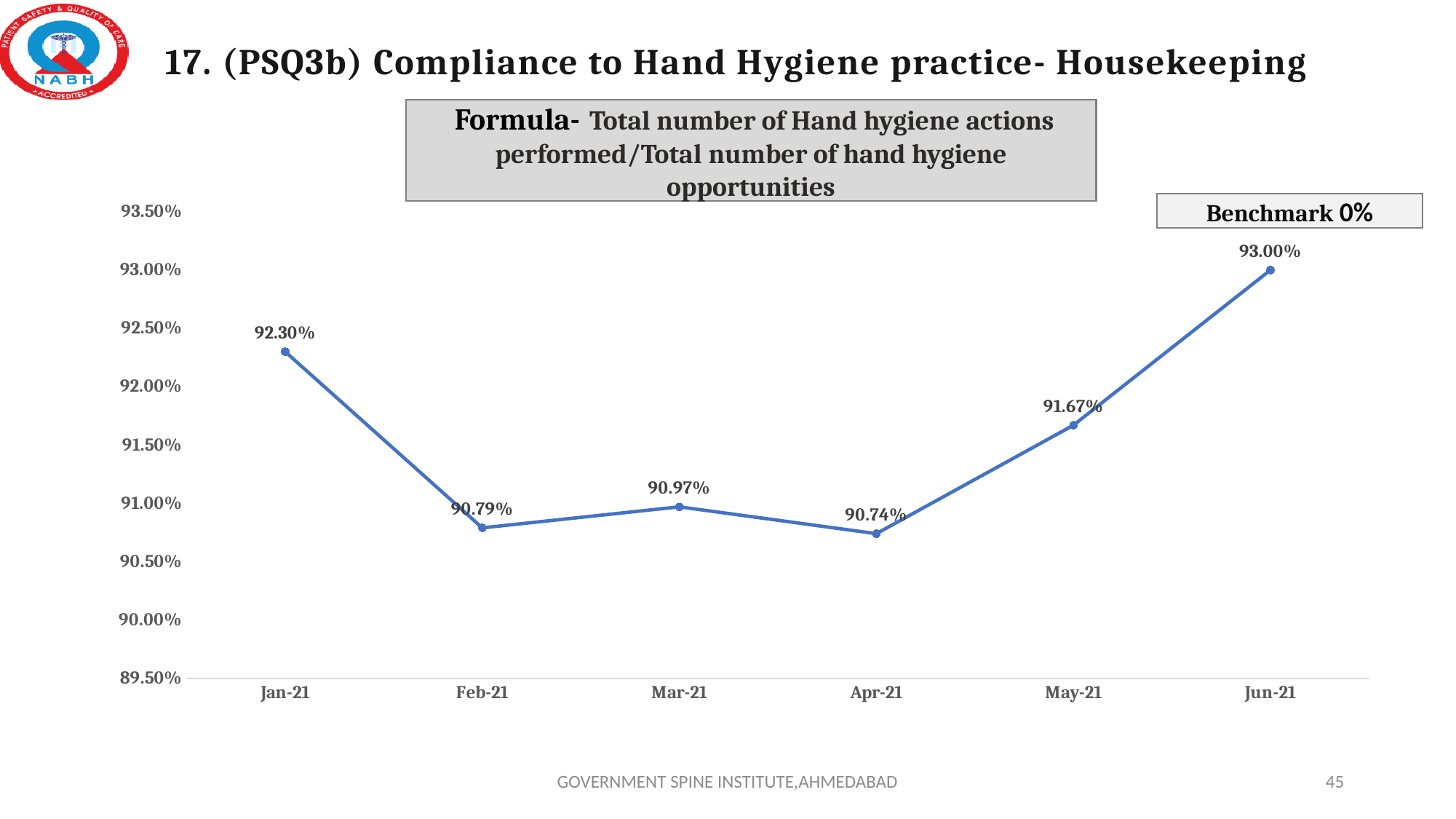
Which month has the lowest compliance value? Apr-21 Which month has the highest compliance value? Jun-21 What is the difference between the Jun-21 and Jan-21 values? 0.70% Is the value for May-21 greater or less than 91.50%? greater What kind of chart is shown on the slide? line chart What is the value plotted for Apr-21? 90.74% What is the hand hygiene compliance value for Jan-21? 92.30% What is the value plotted for May-21? 91.67% Which is larger, the value for Feb-21 or the value for Mar-21? Mar-21 Do the values rise or fall from Apr-21 to Jun-21? rise How many months are plotted on the chart? 6 What is the difference between the Mar-21 and Feb-21 values? 0.18%